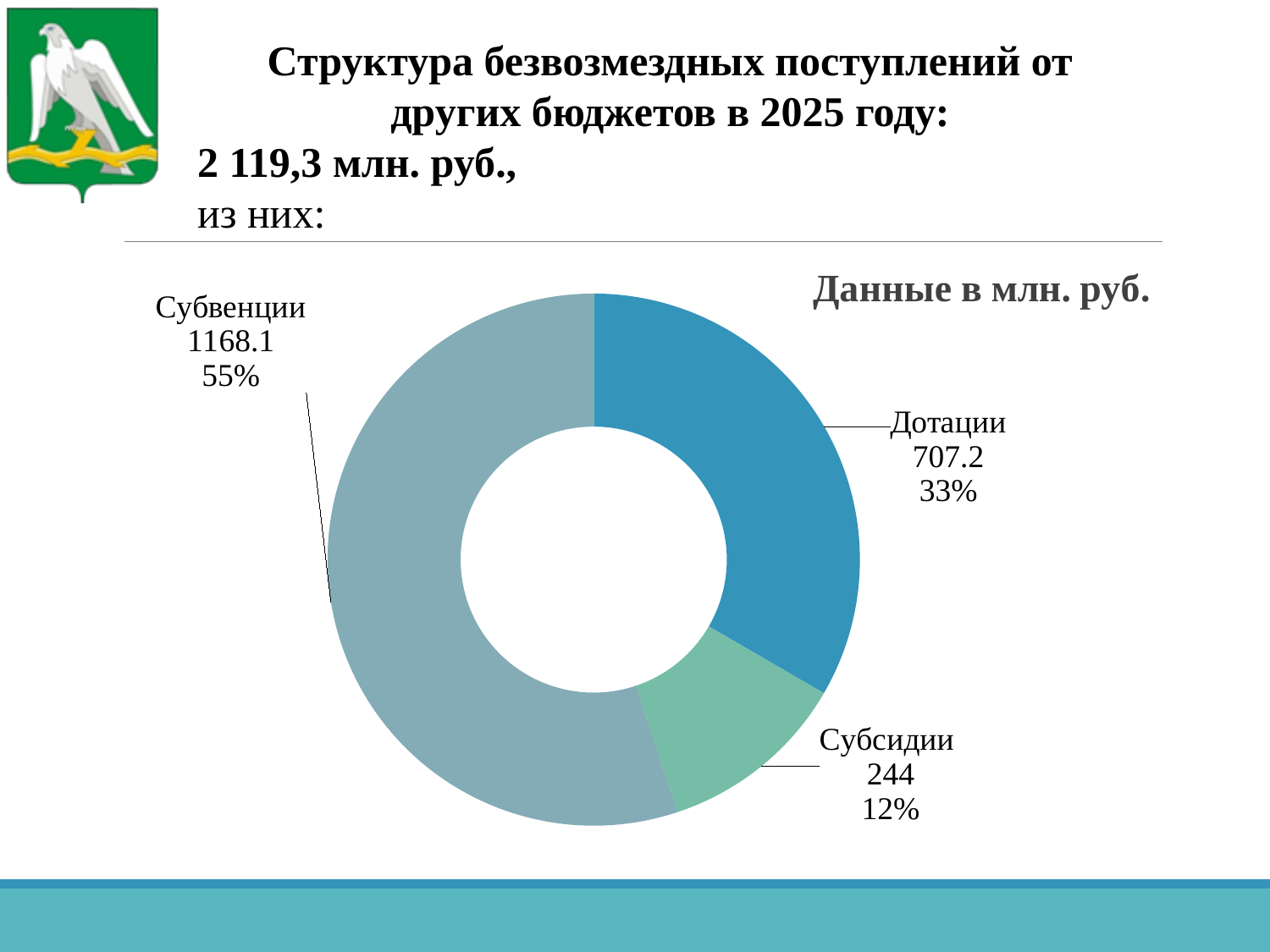
Which category has the smallest share of the chart? Субсидии What is the difference between the values for Субвенции and Дотации? 460.9 In what units are the chart's data given, according to the note on the slide? млн. руб. What share of the chart does Субсидии represent? 12% How many categories are shown in the chart? 3 What is the value for Субвенции? 1168.1 What kind of chart is shown on the slide? Doughnut (pie) chart What share of the chart does Дотации represent? 33% What is the value for Субсидии? 244 Which is larger, the value for Дотации or the value for Субсидии? Дотации What is the value for Дотации? 707.2 Which category has the largest share of the chart? Субвенции